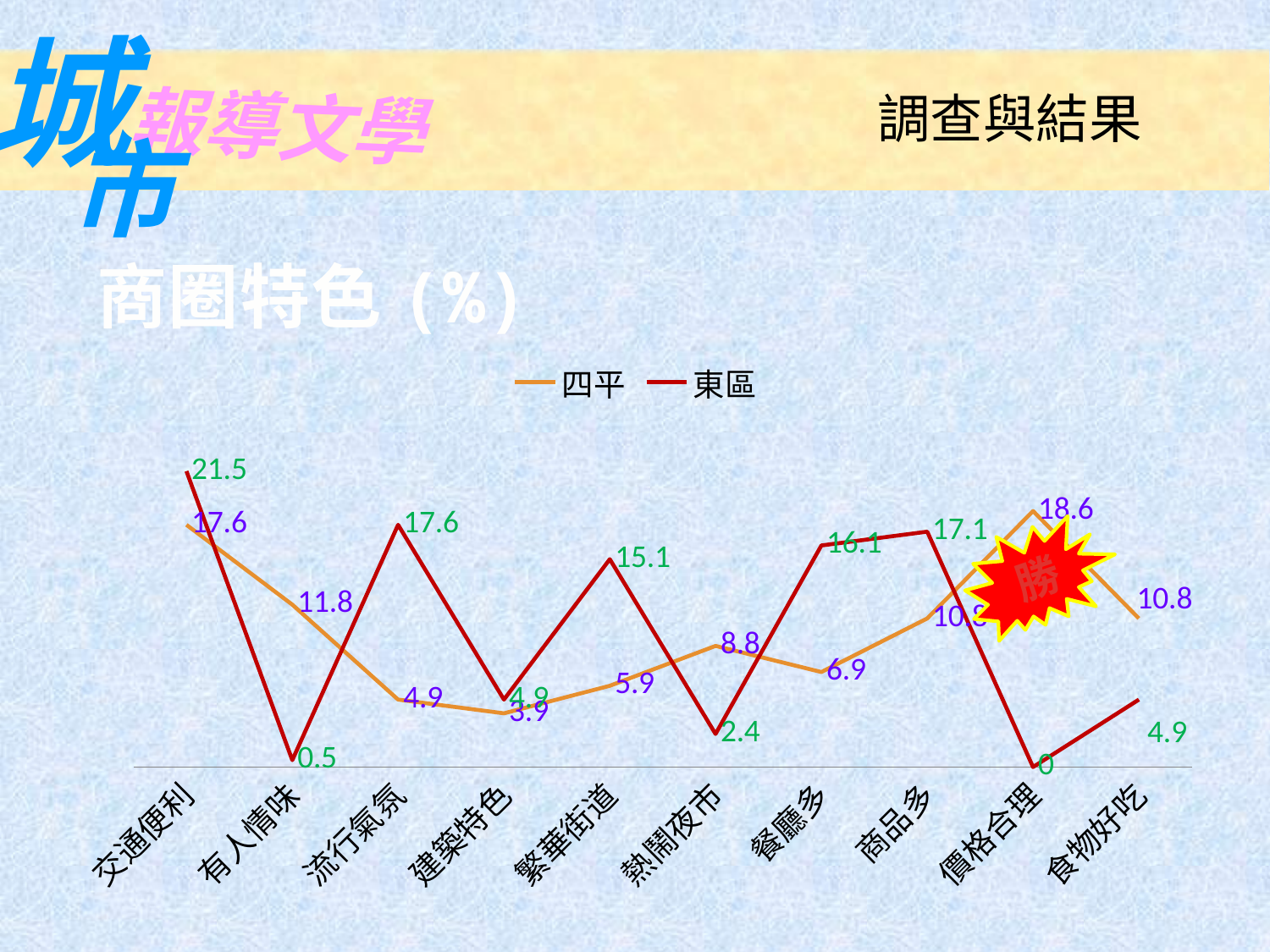
What is the value for 東區 at 交通便利? 21.5 Which category has the lowest value for 東區? 價格合理 What is the value for 四平 at 食物好吃? 10.8 What kind of chart is shown on the slide? line chart Which category has the highest value for 東區? 交通便利 What is the difference between 東區 and 四平 at 交通便利? 3.9 What is the value for 四平 at 有人情味? 11.8 How many categories are plotted along the x axis? 10 Which category has the highest value for 四平? 價格合理 At 流行氣氛, which series has the larger value, 四平 or 東區? 東區 What is the value for 東區 at 熱鬧夜市? 2.4 How many series does the legend list? 2